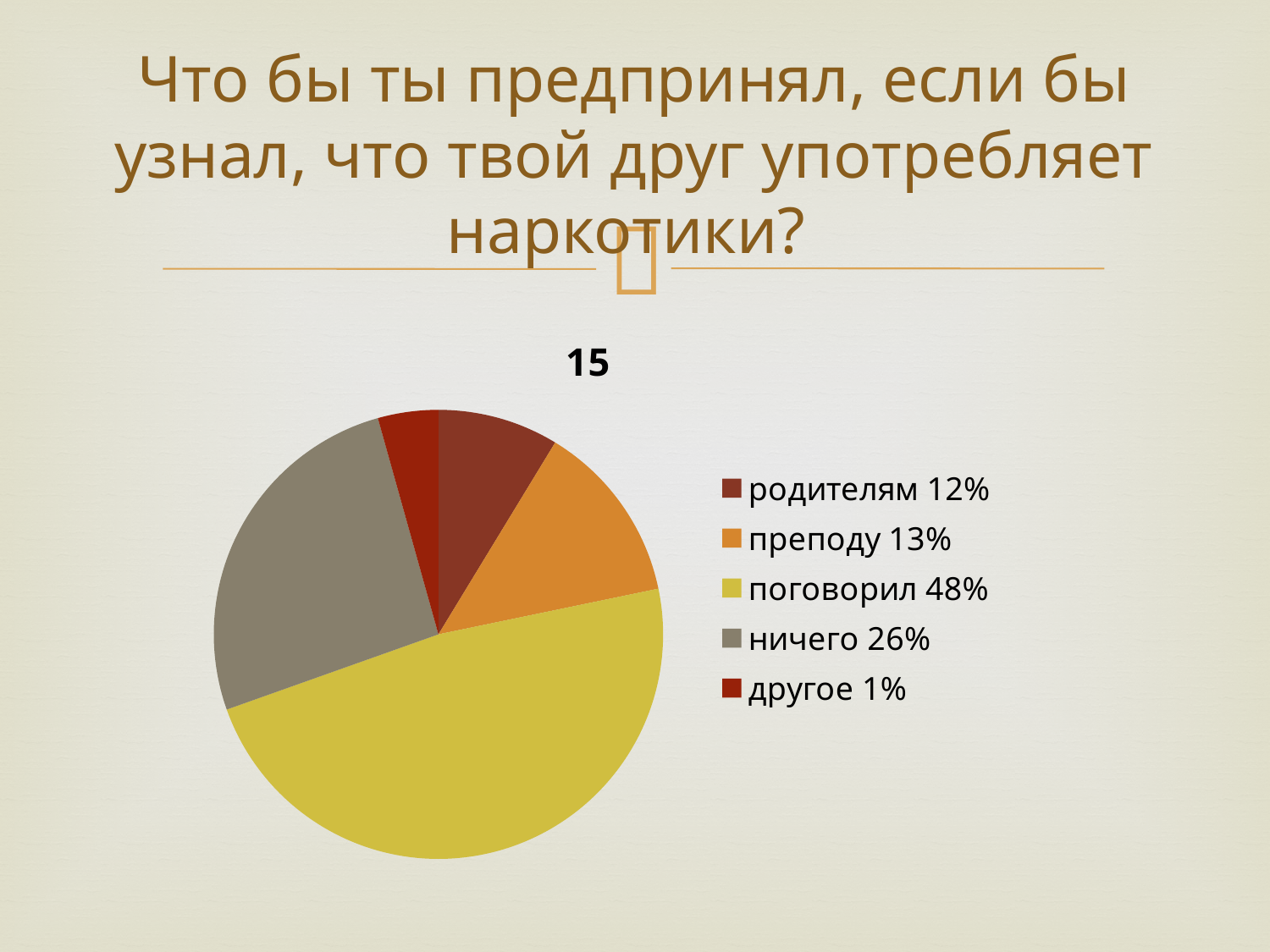
What percentage is shown for "поговорил"? 48% What percentage is shown for "родителям"? 12% What percentage is shown for "ничего"? 26% What is the difference in percentage points between "поговорил" and "ничего"? 22 What kind of chart is shown on the slide? pie chart What is the title of the chart? 15 What colour is the slice for "поговорил"? yellow Which is larger, the share for "ничего" or the share for "преподу"? ничего What percentage is shown for "преподу"? 13% How many slices does the pie chart have? 5 Which category has the smallest share of the pie? другое Which category has the largest share of the pie? поговорил